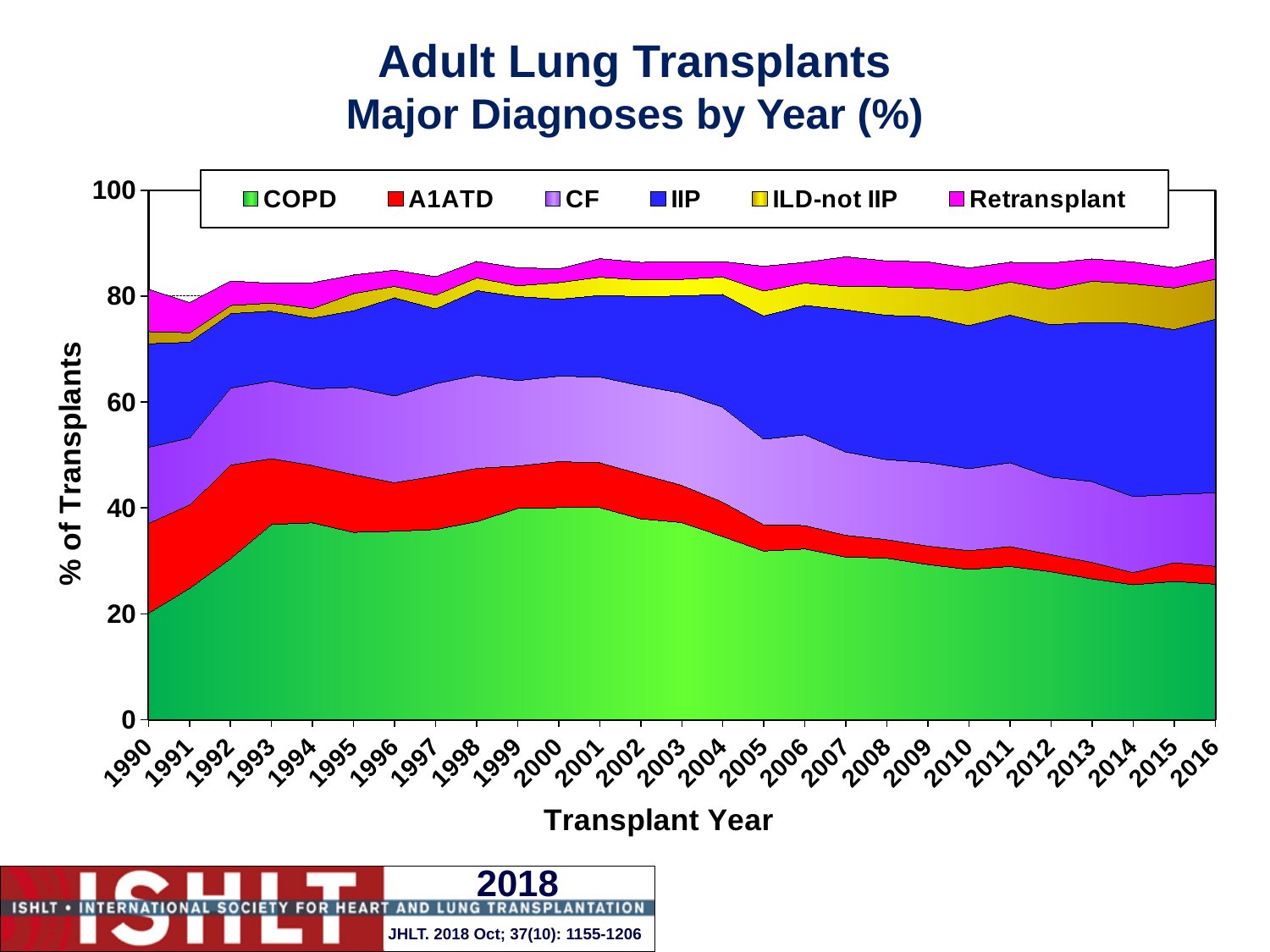
Which year has the larger COPD share of transplants, 2000 or 2016? 2000 Is the COPD share of transplants in 2016 greater or less than 40? less How many transplant years are shown along the x axis? 27 Is the COPD share of transplants in 1993 greater or less than 40? less Does the COPD share of transplants rise or fall from 2000 to 2016? fall Is the COPD share of transplants in 2016 greater or less than 20? greater What kind of chart is shown on the slide? Stacked area chart How many series does the legend list? 6 Does the COPD share of transplants rise or fall from 1990 to 1993? rise What is the title of the y axis? % of Transplants What is the title of the x axis? Transplant Year